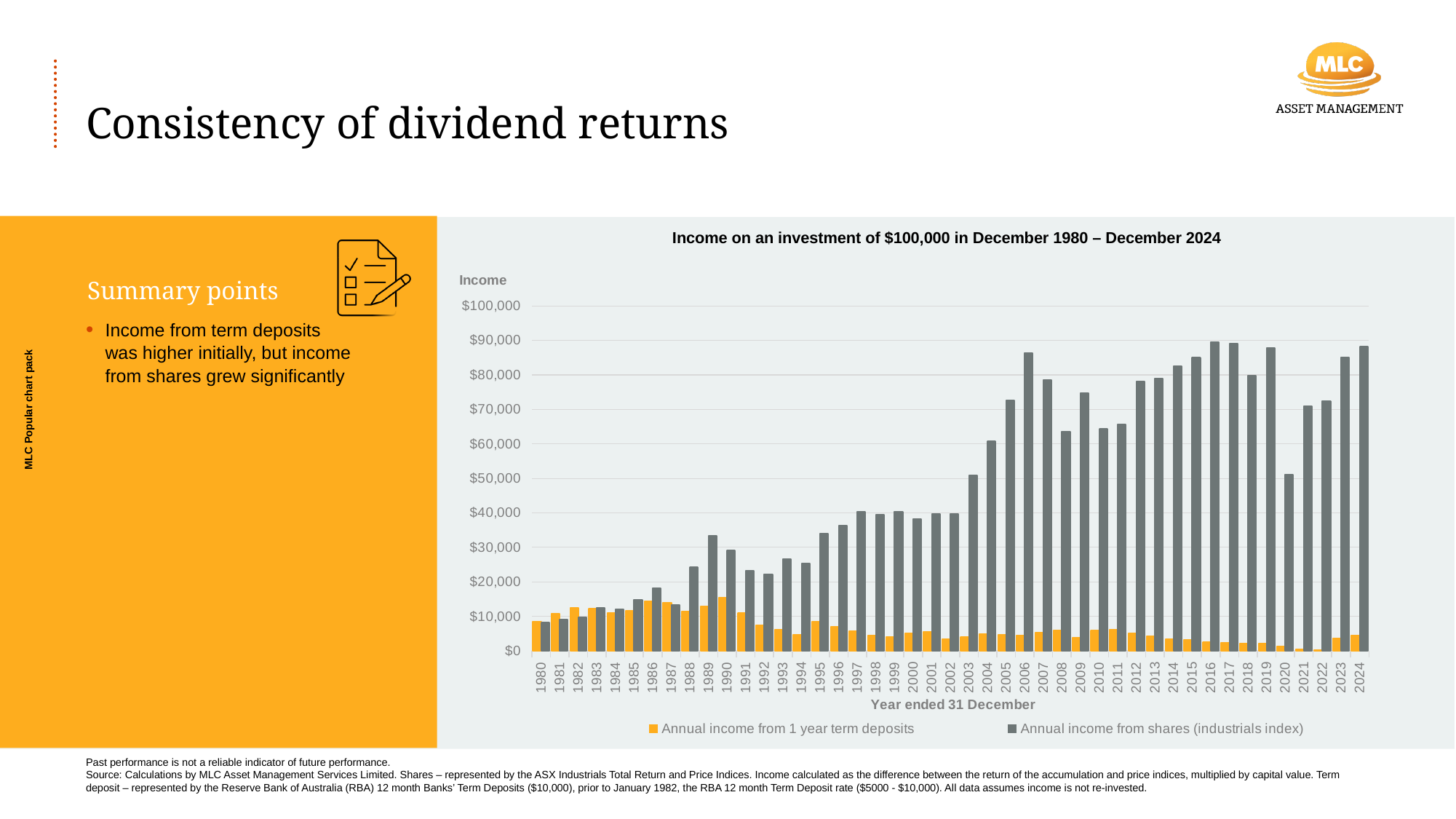
What is the title of the chart? Income on an investment of $100,000 in December 1980 – December 2024 Is the annual income from shares in 2020 greater or less than $60,000? less Is the annual income from 1 year term deposits in 1990 greater or less than $10,000? greater Is the annual income from shares in 2006 greater or less than $80,000? greater How many years are shown along the x axis of the chart? 45 What kind of chart is shown on the slide? Bar chart In 1990, which was larger: annual income from shares or annual income from 1 year term deposits? Annual income from shares How many series does the chart legend list? 2 Overall, does the annual income from shares rise or fall from 1980 to 2024? Rise In 1982, which was larger: annual income from 1 year term deposits or annual income from shares? Annual income from 1 year term deposits